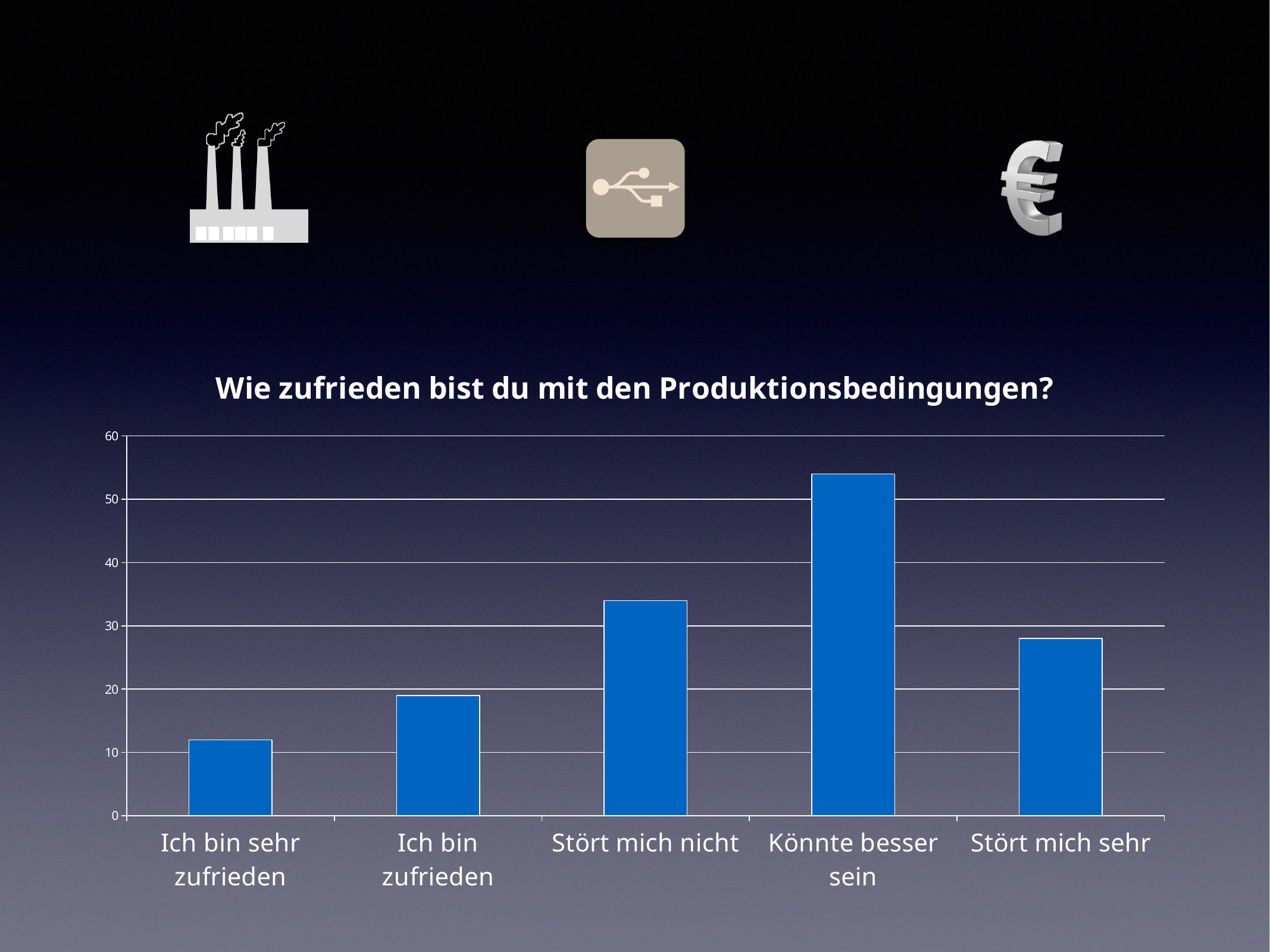
Is the value for "Stört mich nicht" greater or less than 30? greater Is the value for "Ich bin sehr zufrieden" greater or less than 20? less What is the title of the chart? Wie zufrieden bist du mit den Produktionsbedingungen? Is the value for "Ich bin zufrieden" greater or less than 10? greater What kind of chart is shown on the slide? bar chart Which is larger, the value for "Stört mich nicht" or the value for "Stört mich sehr"? Stört mich nicht Which category has the lowest bar? Ich bin sehr zufrieden Which category has the highest bar? Könnte besser sein How many categories are shown on the x axis of the chart? 5 Which is larger, the value for "Ich bin zufrieden" or the value for "Ich bin sehr zufrieden"? Ich bin zufrieden